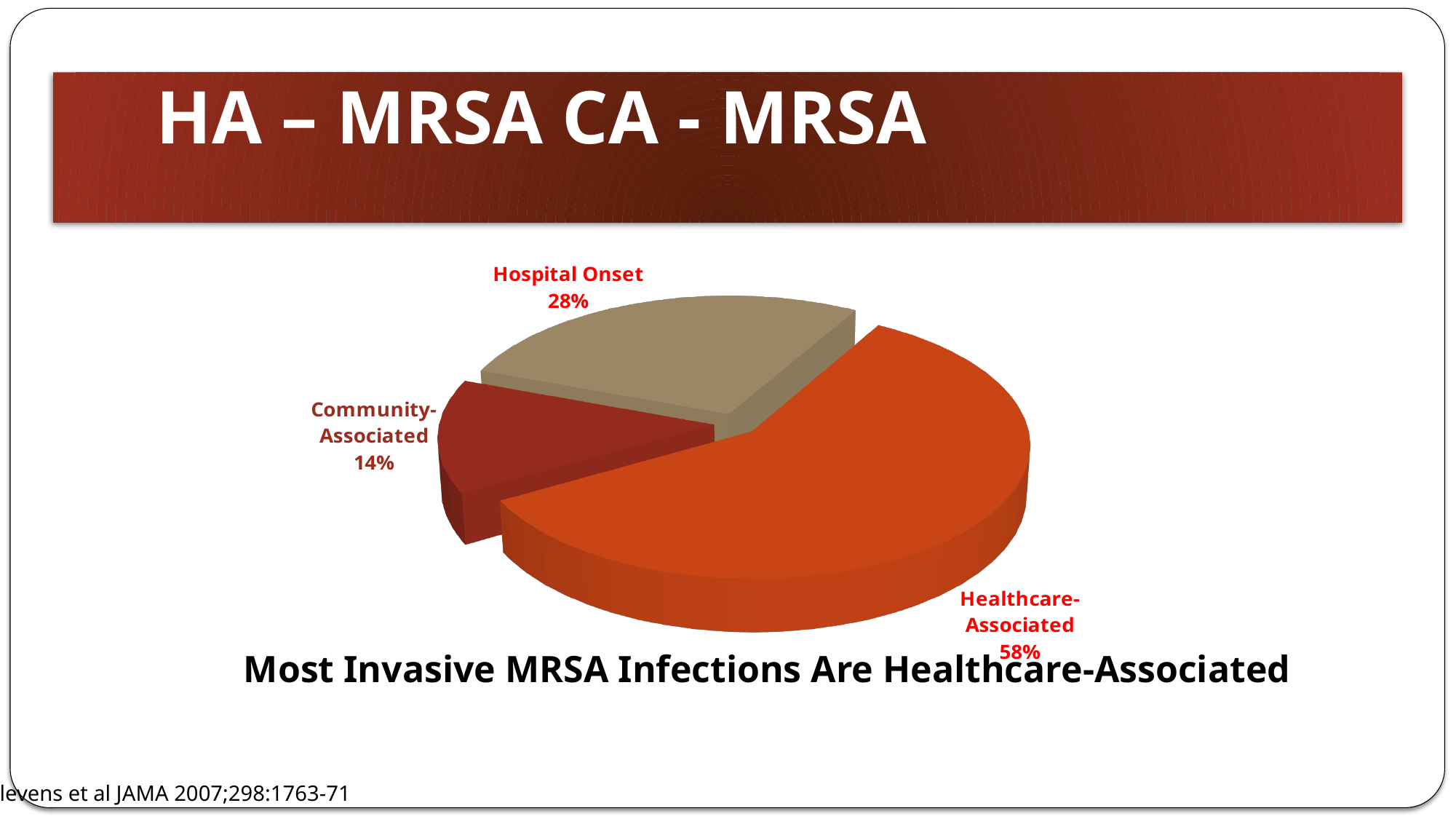
What share of the pie is labelled Community-Associated? 14% Which slice of the pie is the largest? Healthcare-Associated What kind of chart is shown on the slide? Pie chart Which is larger, the Hospital Onset slice or the Community-Associated slice? Hospital Onset What is the caption printed below the pie chart? Most Invasive MRSA Infections Are Healthcare-Associated What share of the pie is labelled Healthcare-Associated? 58% What colour is the Healthcare-Associated slice? Orange What is the difference in percentage points between the Healthcare-Associated and Hospital Onset slices? 30 What share of the pie is labelled Hospital Onset? 28% What is the difference in percentage points between the Hospital Onset and Community-Associated slices? 14 How many slices does the pie chart have? 3 Which slice of the pie is the smallest? Community-Associated